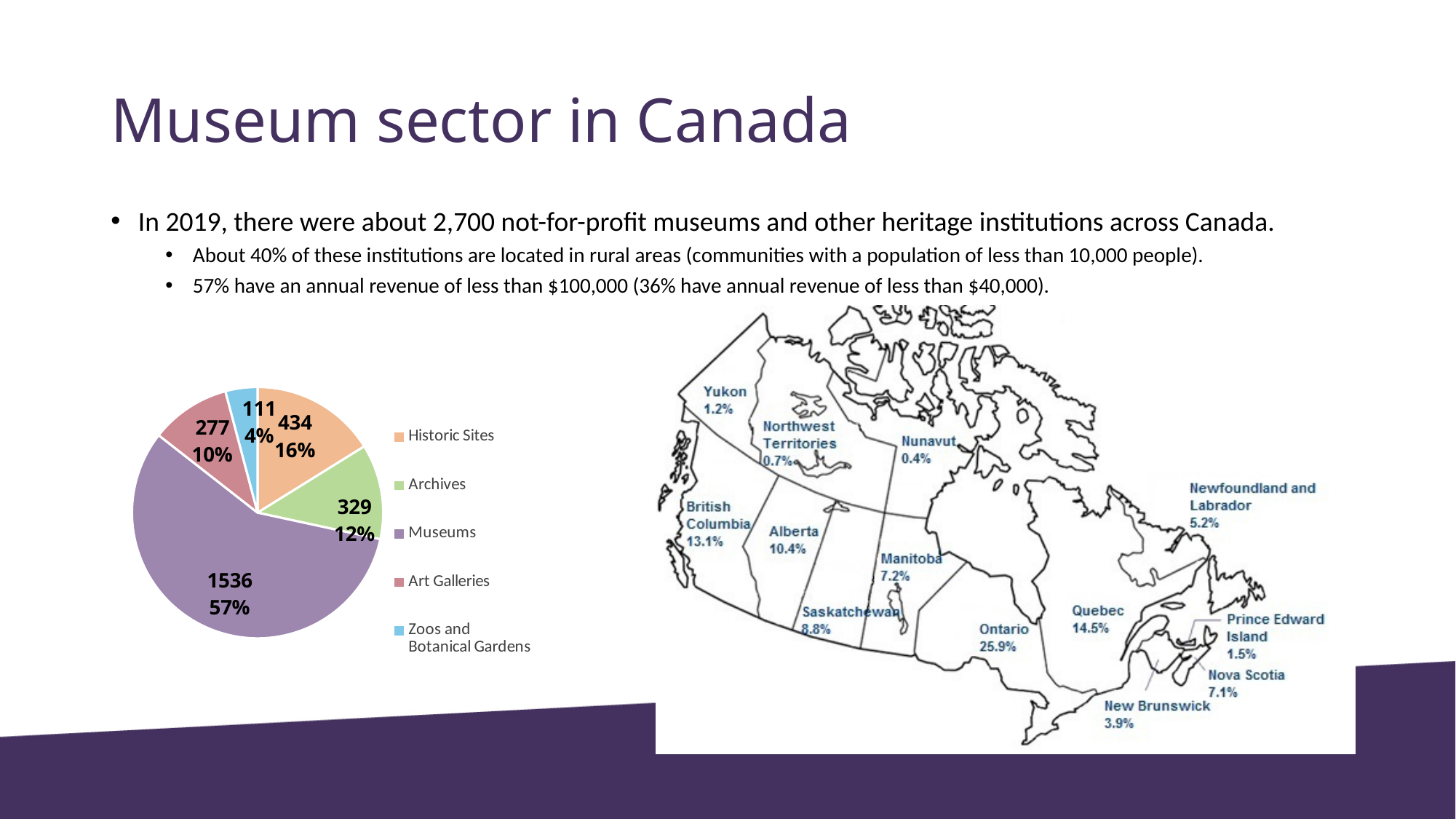
In the pie chart, what percentage share do Zoos and Botanical Gardens have? 4% In the pie chart, which is larger: Archives or Art Galleries? Archives Which category in the pie chart has the smallest slice? Zoos and Botanical Gardens In the pie chart, how many institutions are Museums? 1536 How many categories does the pie chart's legend list? 5 In the pie chart, what share of the total do Historic Sites make up? 16% Which category in the pie chart has the largest slice? Museums In the pie chart, what is the difference between the number of Historic Sites and the number of Art Galleries? 157 In the pie chart, what is the value for Archives? 329 What kind of chart is shown on the left of the slide? pie chart In the pie chart, what colour is the Museums slice? purple On the map of Canada, what percentage is shown for Ontario? 25.9%